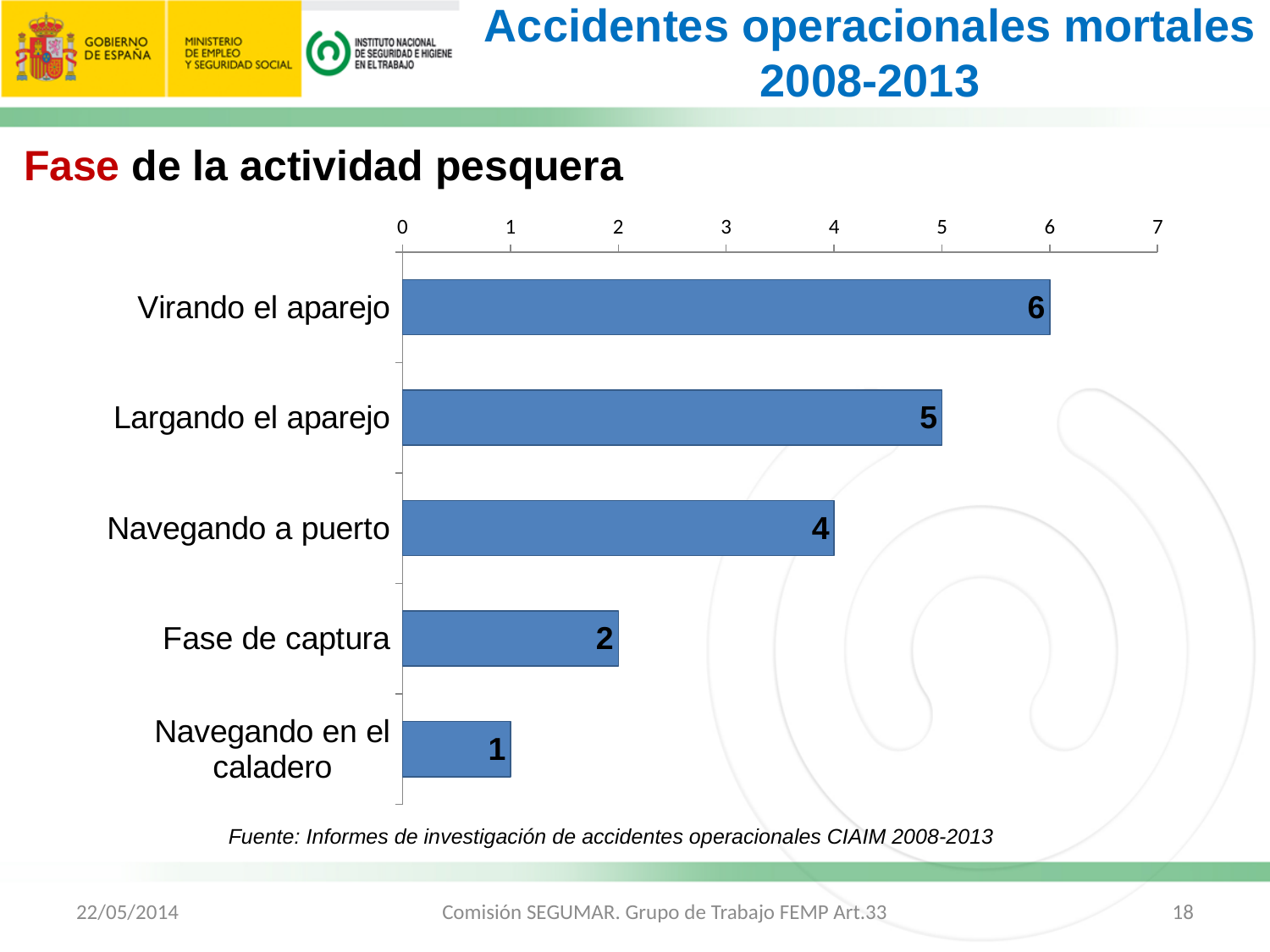
Which category has the highest value? Virando el aparejo How many categories are shown in the chart? 5 What is the value for Fase de captura? 2 Which category has the lowest value? Navegando en el caladero What kind of chart is shown on the slide? Bar chart Which is larger, the value for Largando el aparejo or the value for Navegando a puerto? Largando el aparejo What is the value for Navegando a puerto? 4 What is the value for Navegando en el caladero? 1 What is the value for Virando el aparejo? 6 What is the difference between the values for Virando el aparejo and Fase de captura? 4 What is the value for Largando el aparejo? 5 What is the total of all the values shown in the chart? 18